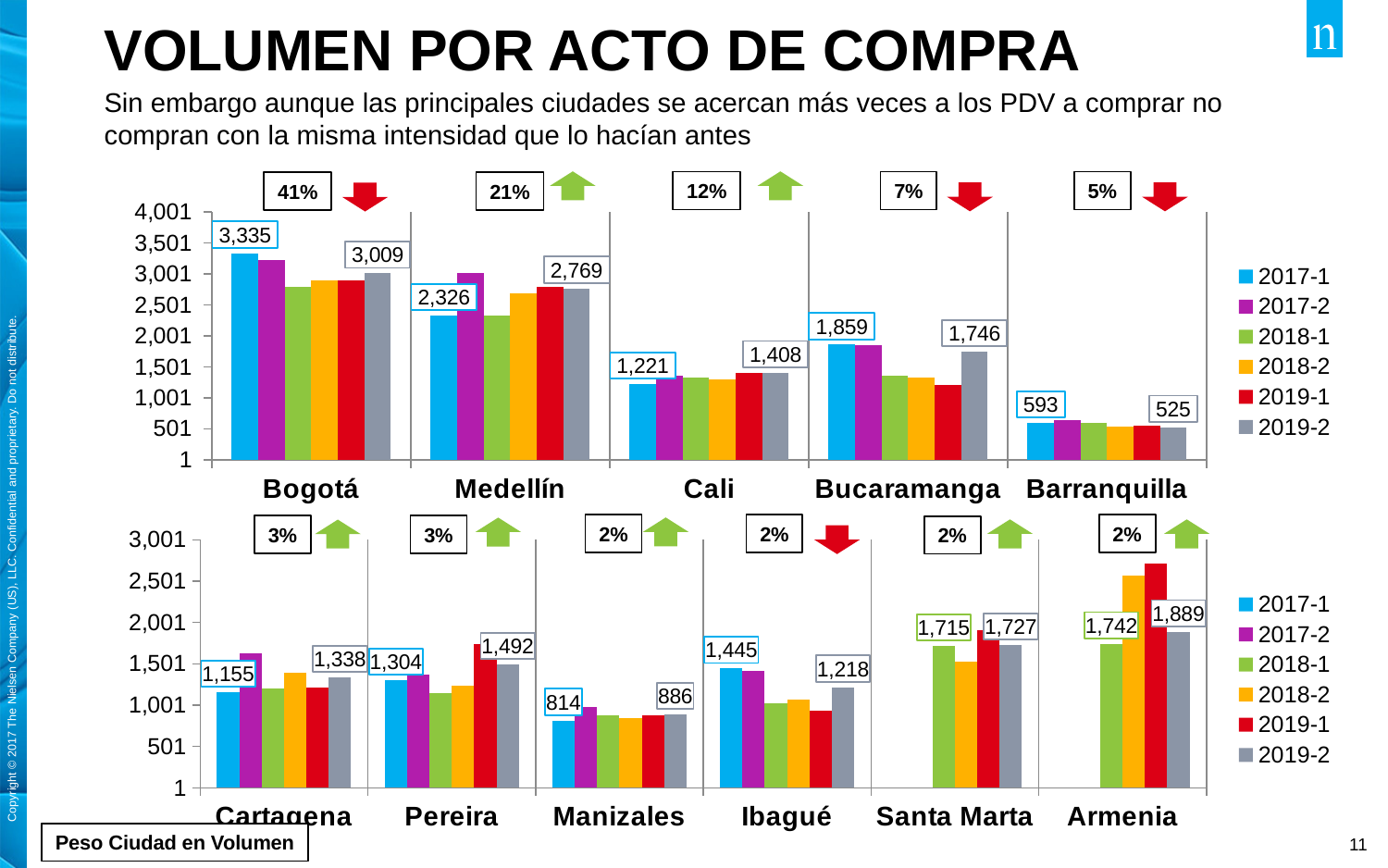
In the top chart, is the 2019-2 value for Cali greater or less than the 2019-2 value for Bucaramanga? less In the bottom chart, which city has the lowest 2019-2 value? Manizales In the top chart, what is the value for Medellín in 2019-2? 2,769 In the bottom chart, what is the difference between Pereira's 2019-2 value and its 2017-1 value? 188 In the top chart, what is the difference between Bogotá's 2017-1 value and its 2019-2 value? 326 In the top chart, what is the value for Barranquilla in 2019-2? 525 In the bottom chart, what is the value for Ibagué in 2017-1? 1,445 How many series does the legend of the bottom chart list? 6 In the top chart, which city has the highest 2017-1 value? Bogotá How many cities are shown on the x axis of the bottom chart? 6 In the bottom chart, what is the value for Armenia in 2019-2? 1,889 In the top chart, what is the value for Bogotá in 2017-1? 3,335